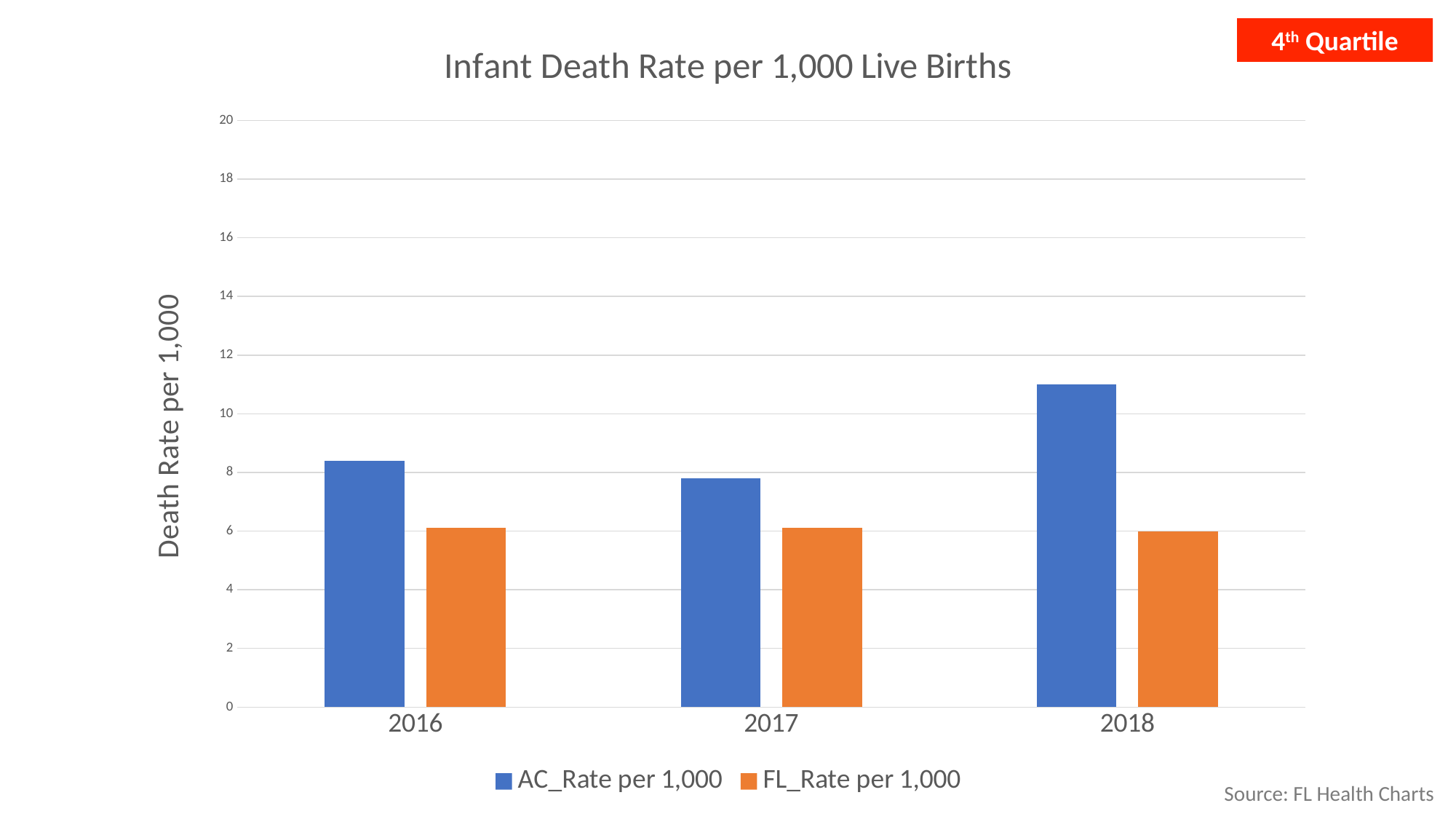
How many series does the legend list? 2 What is the title of the chart? Infant Death Rate per 1,000 Live Births In which year is the AC_Rate per 1,000 highest? 2018 Is the AC_Rate per 1,000 for 2016 greater or less than 8? greater Is the AC_Rate per 1,000 for 2018 greater or less than 10? greater What kind of chart is shown on the slide? bar chart Which is larger in 2018, the AC_Rate per 1,000 or the FL_Rate per 1,000? AC_Rate per 1,000 How many years are shown on the x axis? 3 In which year is the AC_Rate per 1,000 lowest? 2017 Does the AC_Rate per 1,000 rise or fall from 2017 to 2018? rise Is the FL_Rate per 1,000 for 2018 greater or less than 8? less